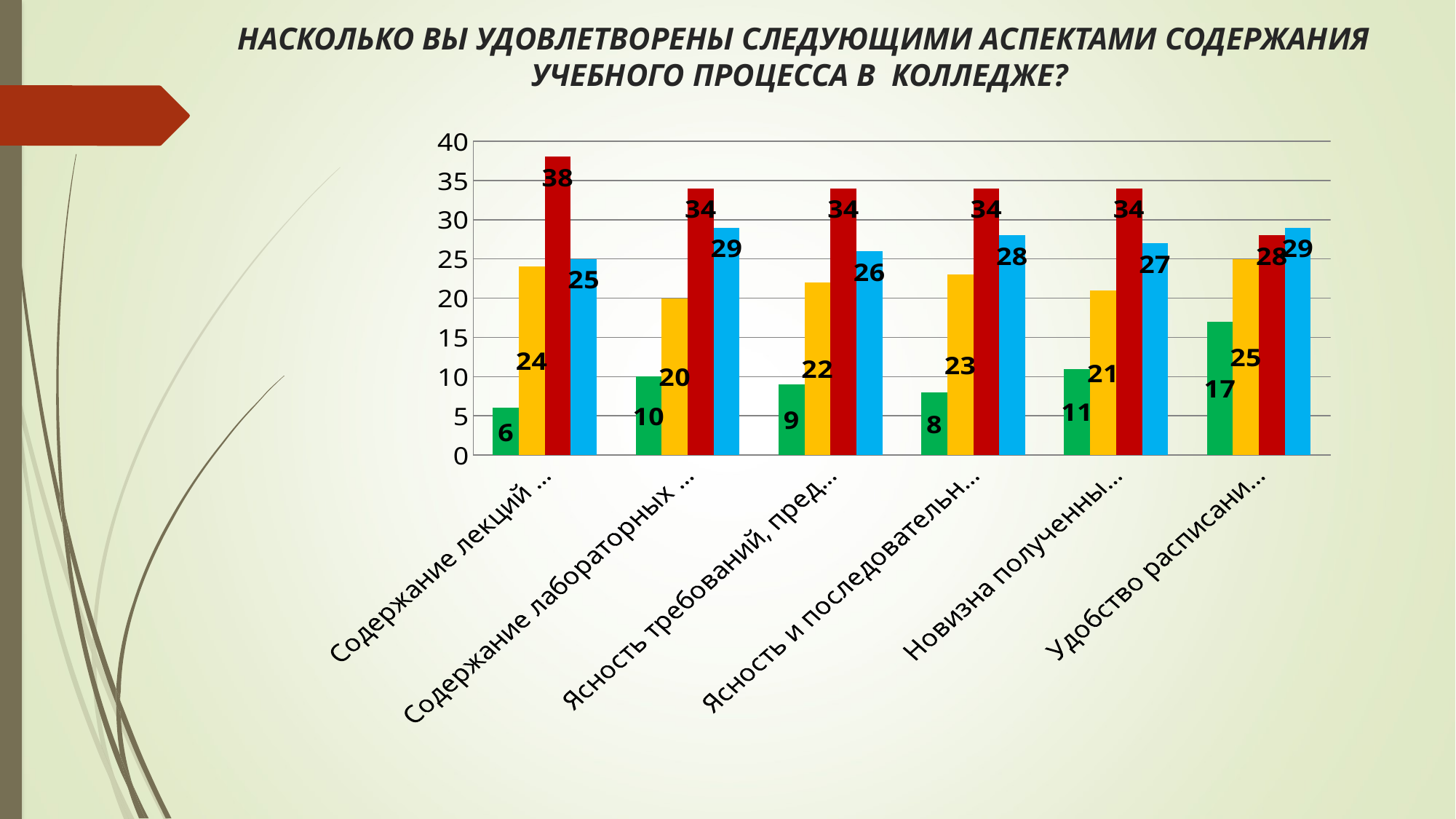
How many bars are shown for each category in the chart? 4 What is the value of the red bar for the category "Содержание лекций ..."? 38 What is the value of the blue bar for the category "Новизна полученны..."? 27 What kind of chart is shown on the slide? bar chart What is the difference between the red bar and the green bar for the category "Содержание лекций ..."? 32 Which category has the highest red bar? Содержание лекций ... How many categories are shown along the x axis of the chart? 6 What is the value of the green bar for the category "Удобство расписани..."? 17 Is the value of the yellow bar for "Содержание лабораторных ..." greater or less than 25? less What is the value of the yellow bar for the category "Ясность и последовательн..."? 23 Which category has the lowest green bar? Содержание лекций ... For the category "Удобство расписани...", which is larger: the red bar or the blue bar? the blue bar